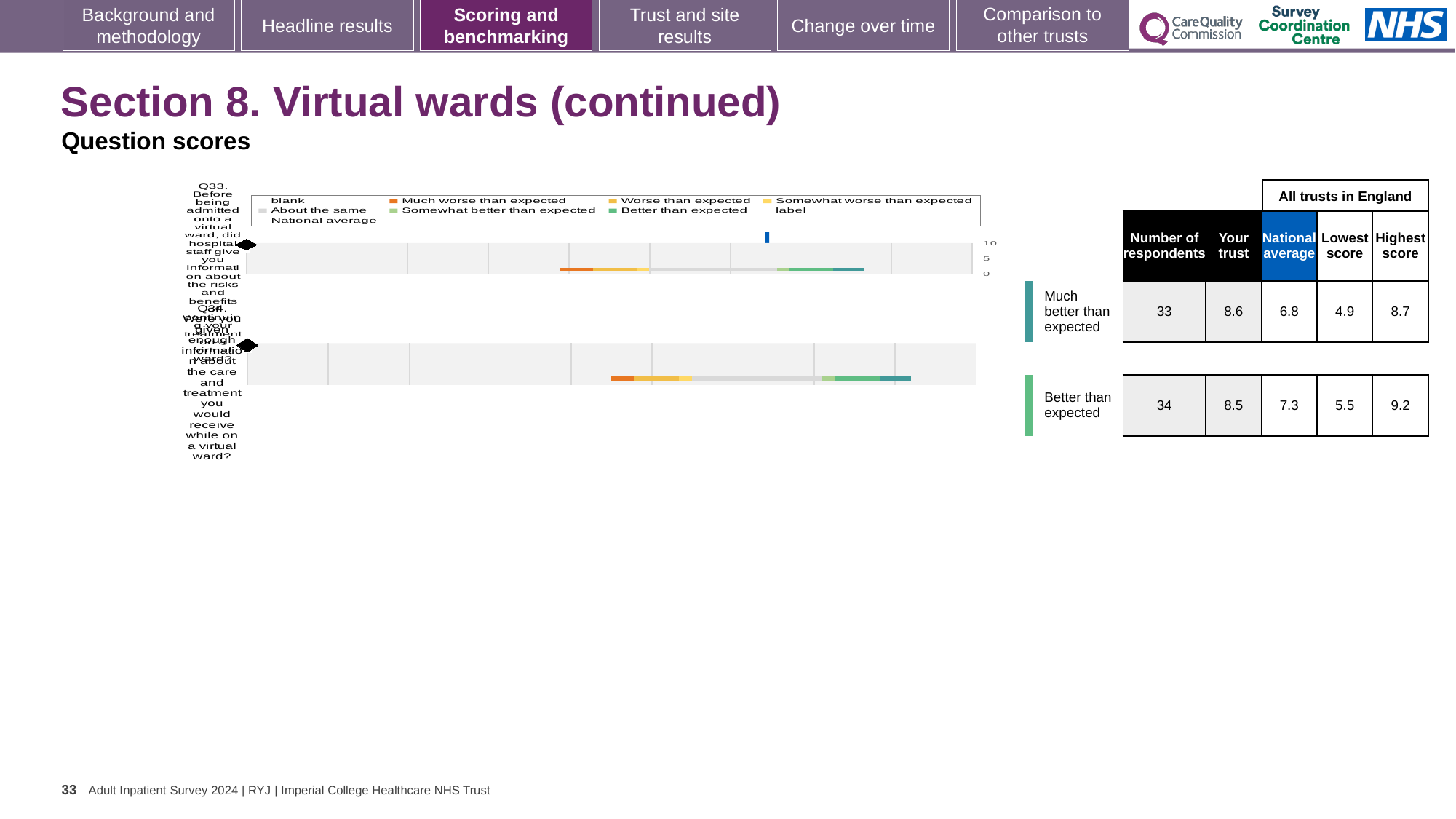
What is the lowest score among all trusts in England for Q33? 4.9 Which question has the higher national average, Q33 or Q34? Q34 What is the 'Your trust' score for Q33? 8.6 What is the 'Your trust' score for Q34? 8.5 What is the difference between the trust's score and the national average for Q33? 1.8 How many questions (categories) are plotted in the chart? 2 What is the national average score for Q33? 6.8 Which benchmark category is Q33 rated as? Much better than expected What is the highest score among all trusts in England for Q34? 9.2 How many respondents answered Q34? 34 What is the national average score for Q34? 7.3 What kind of chart is shown on the slide? bar chart